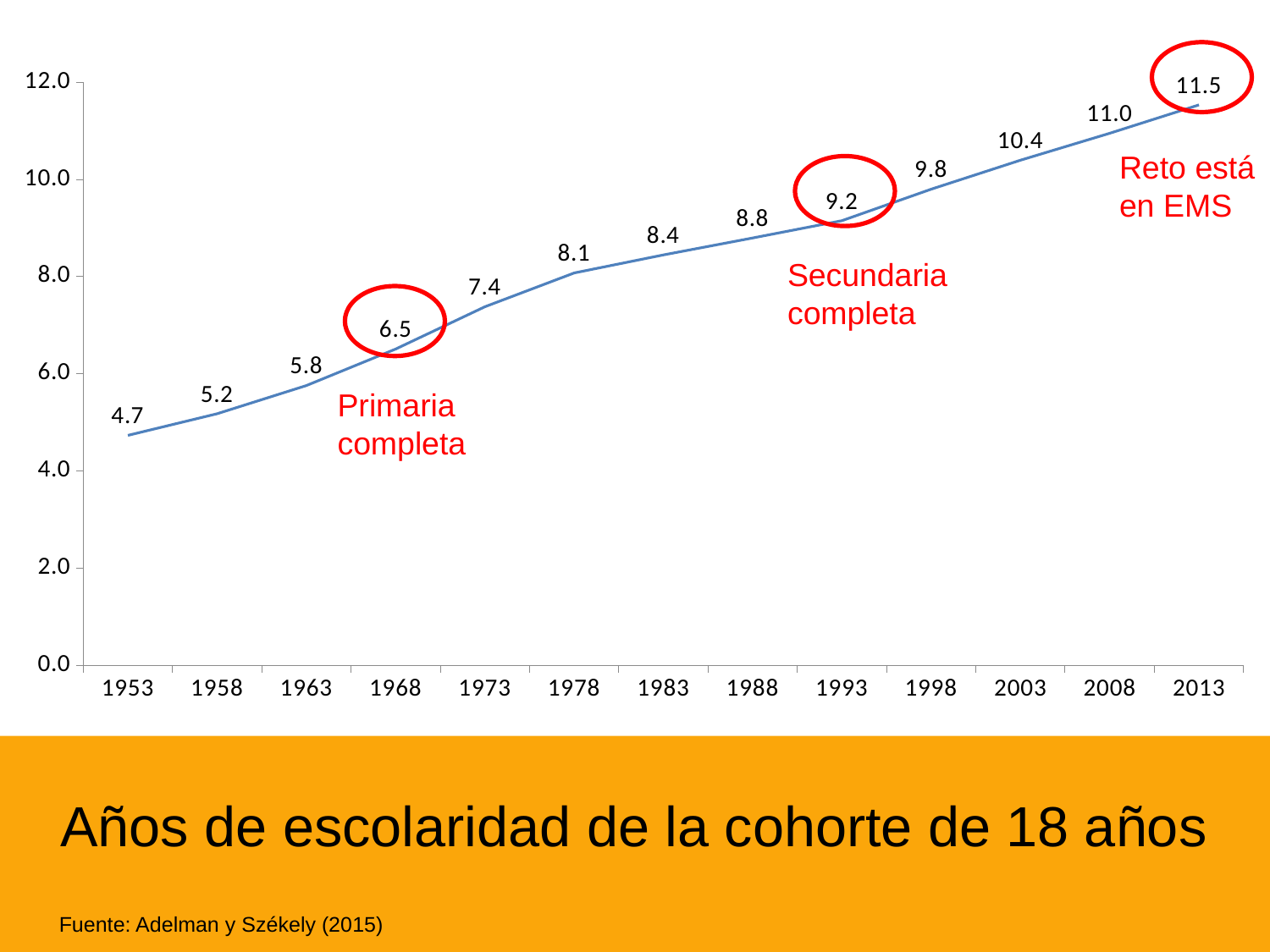
How many years are plotted on the x axis? 13 What is the value for 1953? 4.7 What is the difference between the values for 1993 and 1968? 2.7 What kind of chart is this? line chart What is the difference between the values for 2013 and 1953? 6.8 What is the value for 1968? 6.5 Which year has the highest value? 2013 What is the value for 1993? 9.2 Do the values rise or fall from 1953 to 2013? rise What is the value for 2013? 11.5 Which year has the lowest value? 1953 Which is larger, the value for 1978 or the value for 1988? 1988